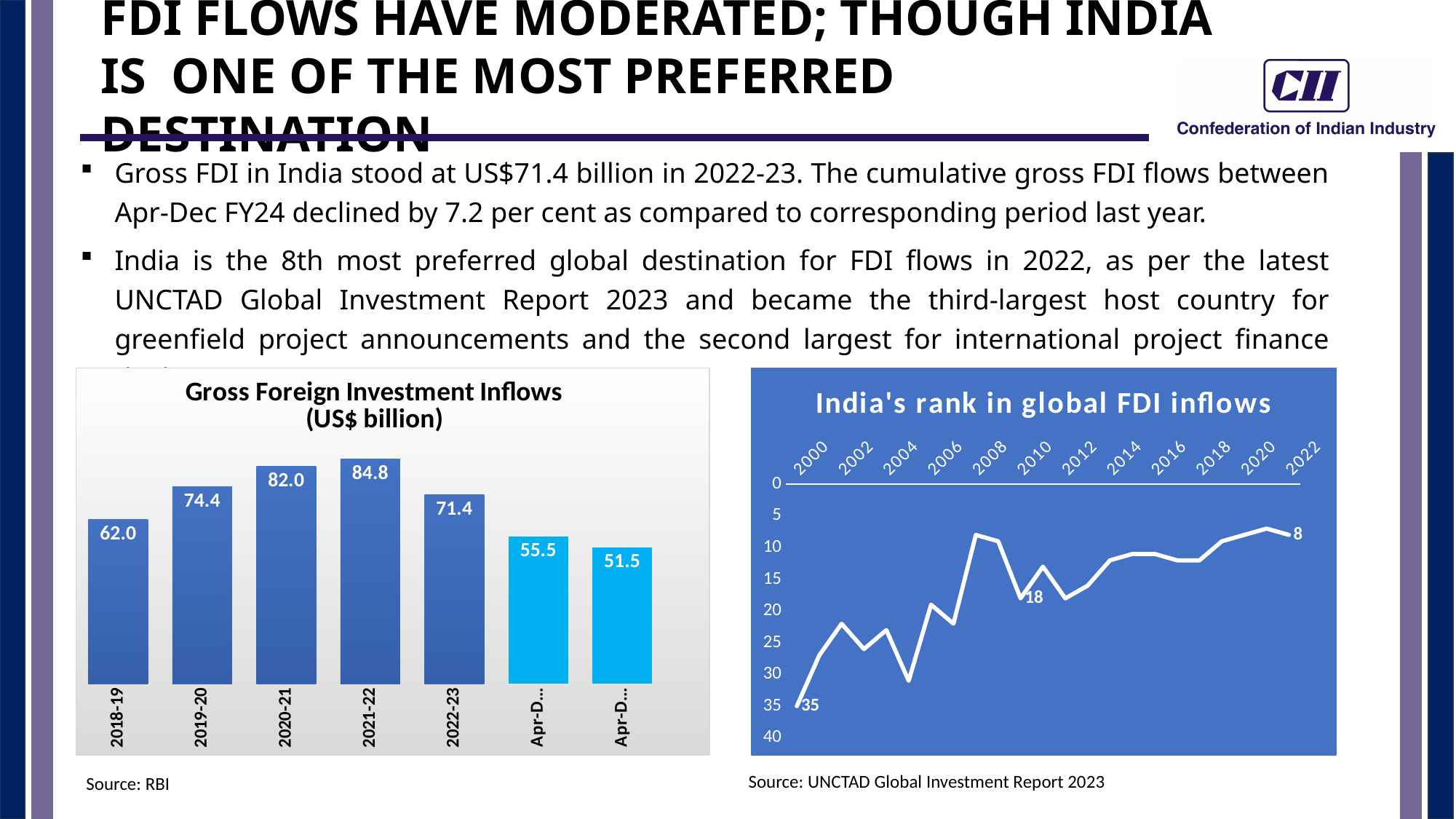
In the India's rank in global FDI inflows chart, what is India's rank in 2000? 35 How many bars are shown in the Gross Foreign Investment Inflows chart? 7 What kind of chart is the Gross Foreign Investment Inflows chart? Bar chart In the Gross Foreign Investment Inflows chart, what colour are the two Apr-Dec bars on the right? Light blue In the India's rank in global FDI inflows chart, what is the difference between India's rank in 2000 and in 2022? 27 In the Gross Foreign Investment Inflows chart, what is the value for 2021-22? 84.8 In the Gross Foreign Investment Inflows chart, what is the difference between the 2021-22 and 2022-23 values? 13.4 In the Gross Foreign Investment Inflows chart, what is the value for 2018-19? 62.0 In the Gross Foreign Investment Inflows chart, which is larger, the value for 2019-20 or for 2020-21? 2020-21 In the India's rank in global FDI inflows chart, what is India's rank in 2022? 8 In the Gross Foreign Investment Inflows chart, which year has the highest value? 2021-22 What kind of chart is the India's rank in global FDI inflows chart? Line chart